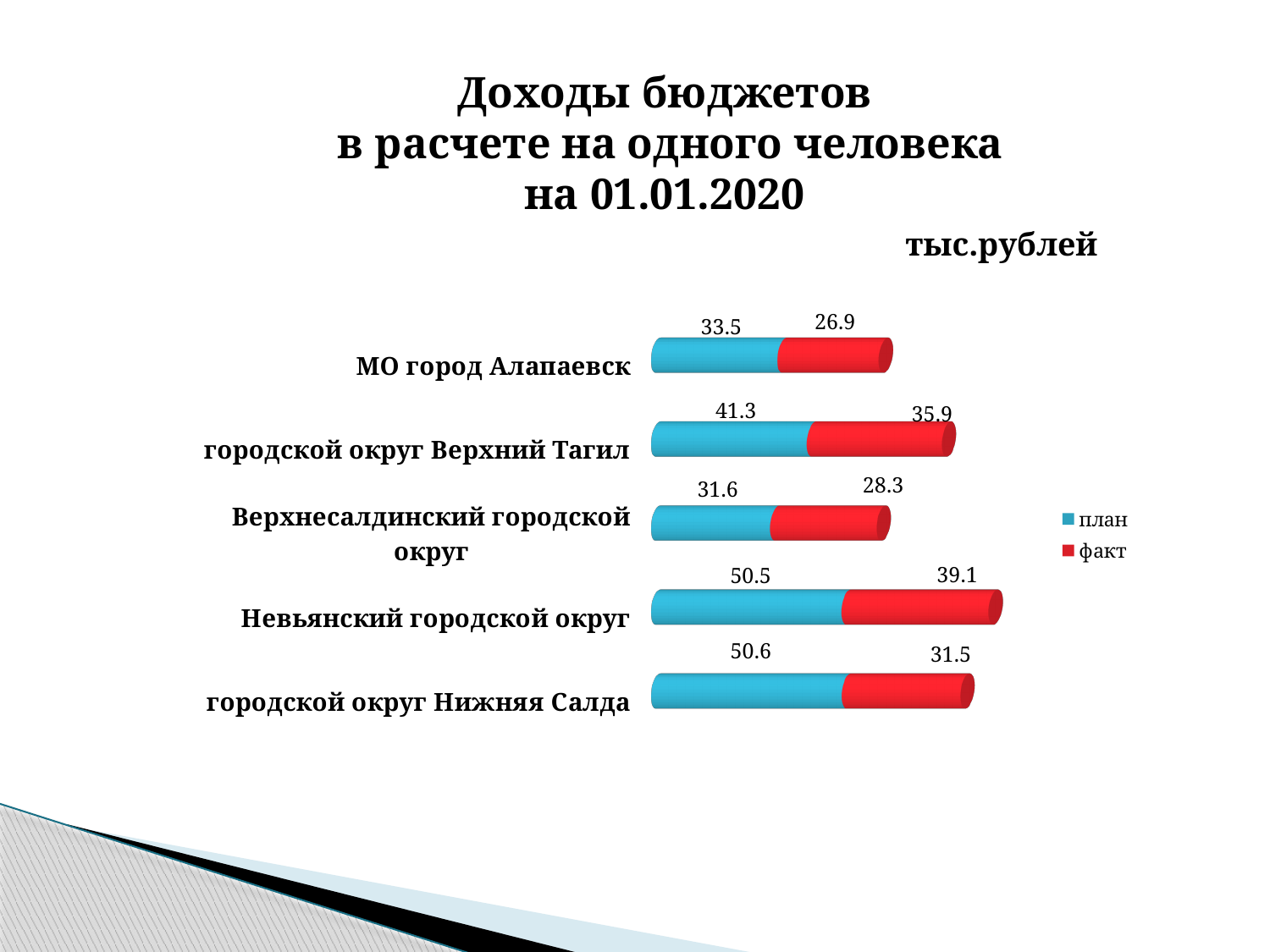
What is the факт value for городской округ Верхний Тагил? 35.9 What is the difference between план and факт for городской округ Нижняя Салда? 19.1 What is the план value for МО город Алапаевск? 33.5 Which is larger: the план value for Верхнесалдинский городской округ or the план value for городской округ Верхний Тагил? городской округ Верхний Тагил How many categories are shown in the chart? 5 What unit is stated for the values in the chart? тыс.рублей Which category has the lowest факт value? МО город Алапаевск What is the total of the stacked bar for Невьянский городской округ? 89.6 Which category has the highest факт value? Невьянский городской округ What kind of chart is shown on the slide? Stacked bar chart How many series does the legend list? 2 What is the факт value for городской округ Нижняя Салда? 31.5